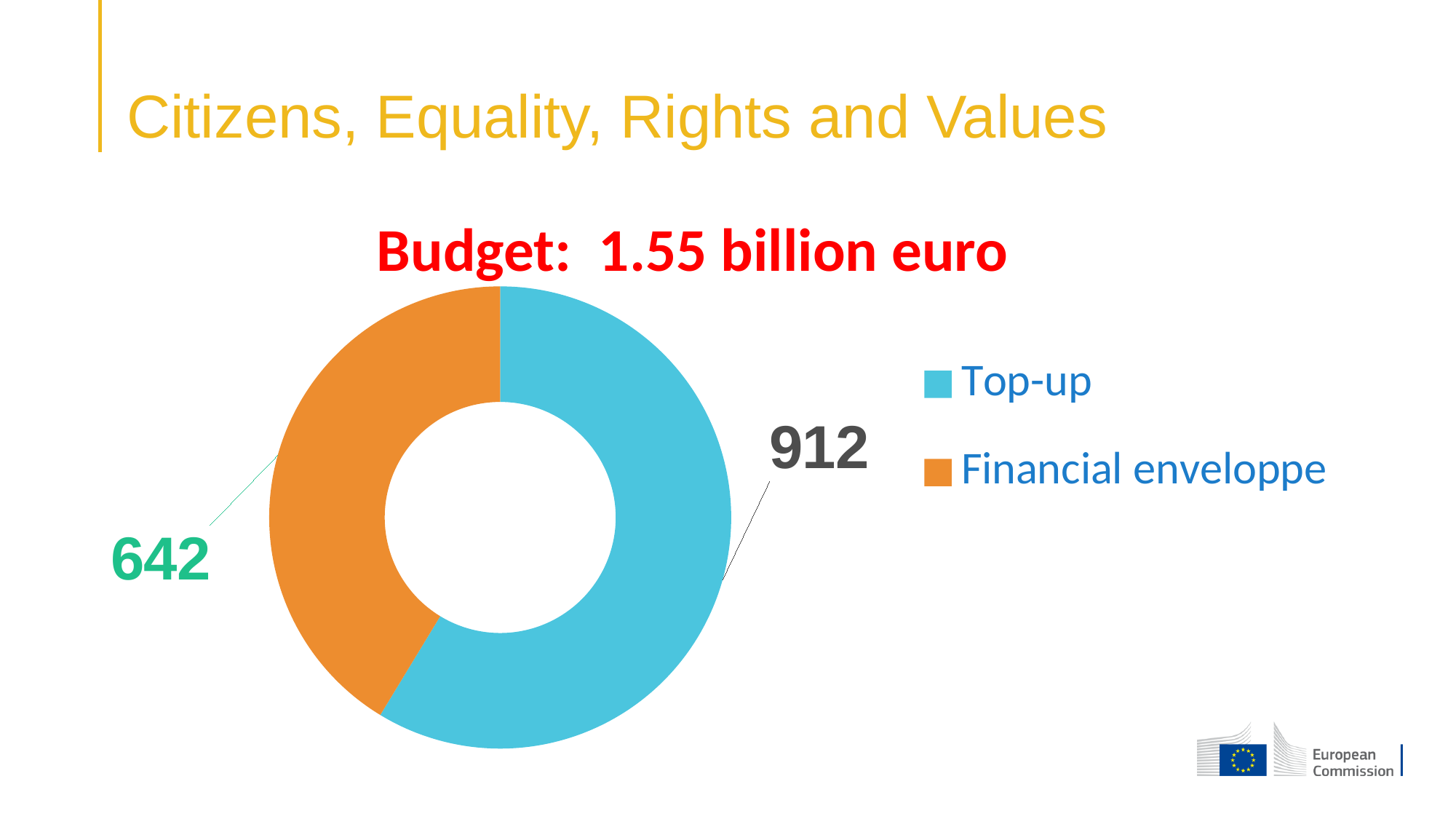
What is the difference between the Top-up value and the Financial enveloppe value? 270 What is the value for Financial enveloppe? 642 What is the title of the chart? Budget: 1.55 billion euro What is the value for Top-up? 912 How many slices does the chart have? 2 Which slice is the largest? Top-up What colour is the Financial enveloppe slice? Orange Which slice is the smallest? Financial enveloppe Which is larger, Top-up or Financial enveloppe? Top-up What kind of chart is shown on the slide? Doughnut chart What is the sum of the two slice values? 1554 How many entries does the legend list? 2